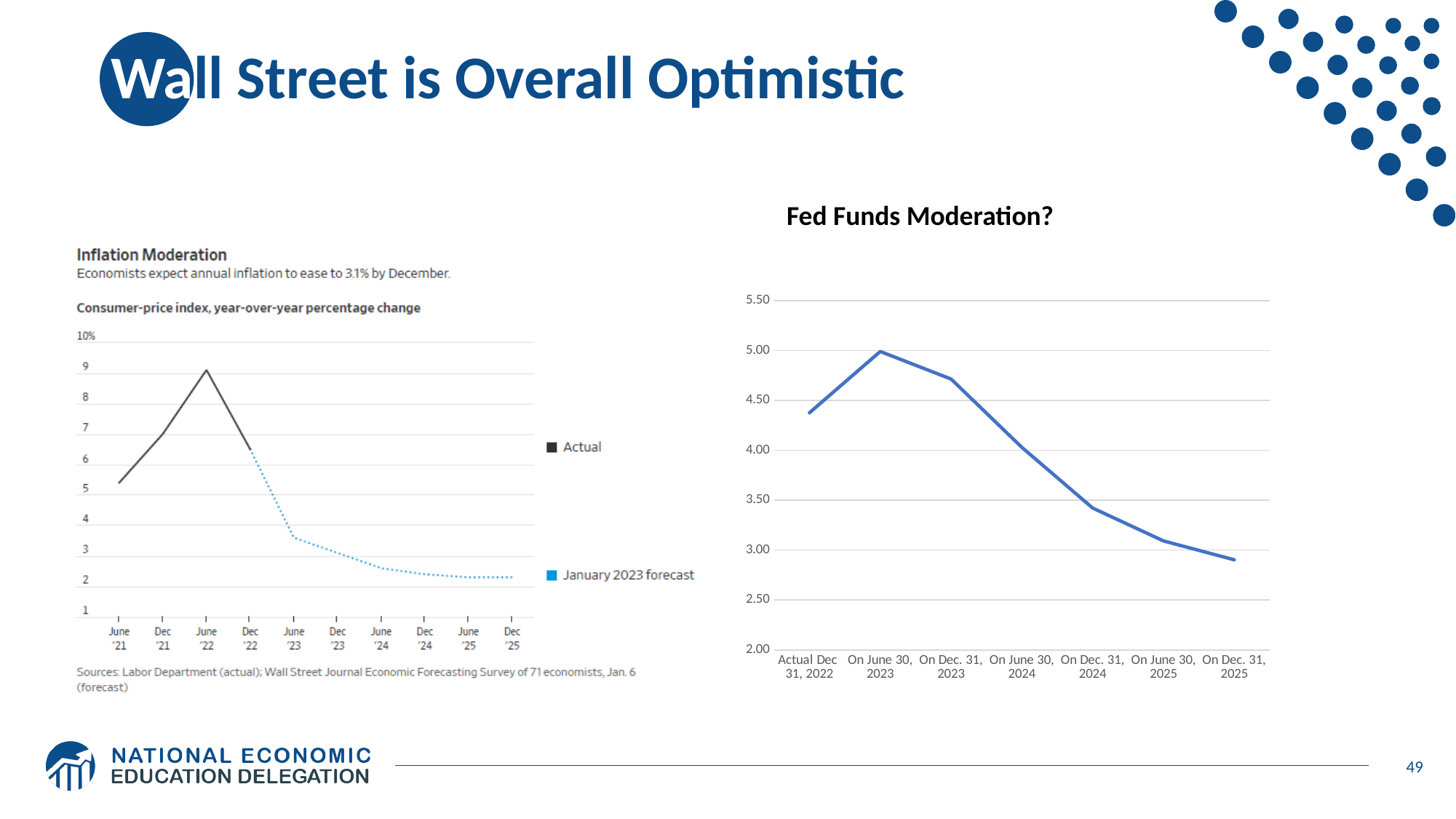
In the 'Fed Funds Moderation?' chart, is the value for Actual Dec 31, 2022 greater or less than 4.00? greater In the 'Fed Funds Moderation?' chart, which date has the lowest value? On Dec. 31, 2025 In the 'Inflation Moderation' chart, which is larger: the value at Dec '22 or the value at June '23? Dec '22 In the 'Fed Funds Moderation?' chart, is the value for On Dec. 31, 2024 greater or less than 3.50? less In the 'Fed Funds Moderation?' chart, do the values rise or fall from June 30, 2023 to Dec. 31, 2025? fall In the 'Inflation Moderation' chart, is the forecast value for Dec '25 greater or less than 3%? less How many data points are plotted in the 'Fed Funds Moderation?' chart? 7 In the 'Fed Funds Moderation?' chart, which date has the highest value? On June 30, 2023 What kind of chart is the 'Fed Funds Moderation?' chart on the right? line chart How many series does the legend of the 'Inflation Moderation' chart list? 2 In the 'Inflation Moderation' chart, at which date does the Actual line reach its peak? June '22